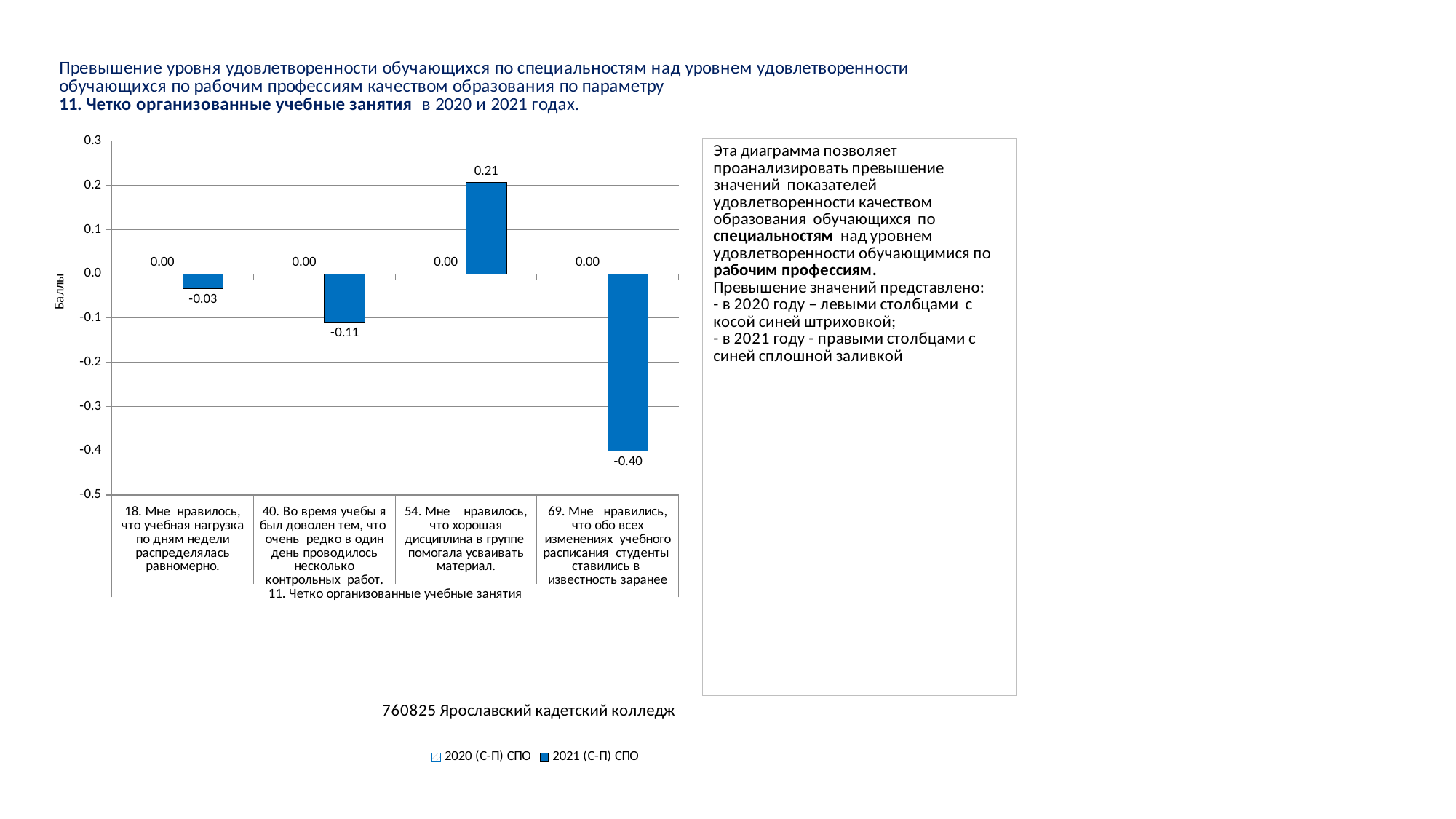
What is the difference between the 2021 (С-П) СПО values for category 54 and category 69? 0.61 What is the label of the vertical axis of the chart? Баллы Which category has the lowest 2021 (С-П) СПО value? 69. Мне нравились, что обо всех изменениях учебного расписания студенты ставились в известность заранее How many categories are shown on the x axis of the chart? 4 What type of chart is shown on the slide? bar chart What is the 2021 (С-П) СПО value for category 18 (Мне нравилось, что учебная нагрузка по дням недели распределялась равномерно)? -0.03 What is the 2020 (С-П) СПО value for category 40 (Во время учебы я был доволен тем, что очень редко в один день проводилось несколько контрольных работ)? 0.00 What is the 2021 (С-П) СПО value for category 69 (Мне нравились, что обо всех изменениях учебного расписания студенты ставились в известность заранее)? -0.40 How many series does the legend list? 2 Which category has the highest 2021 (С-П) СПО value? 54. Мне нравилось, что хорошая дисциплина в группе помогала усваивать материал. Which is larger for 2021 (С-П) СПО: the value for category 18 or the value for category 40? category 18 (-0.03) What is the 2021 (С-П) СПО value for category 54 (Мне нравилось, что хорошая дисциплина в группе помогала усваивать материал)? 0.21